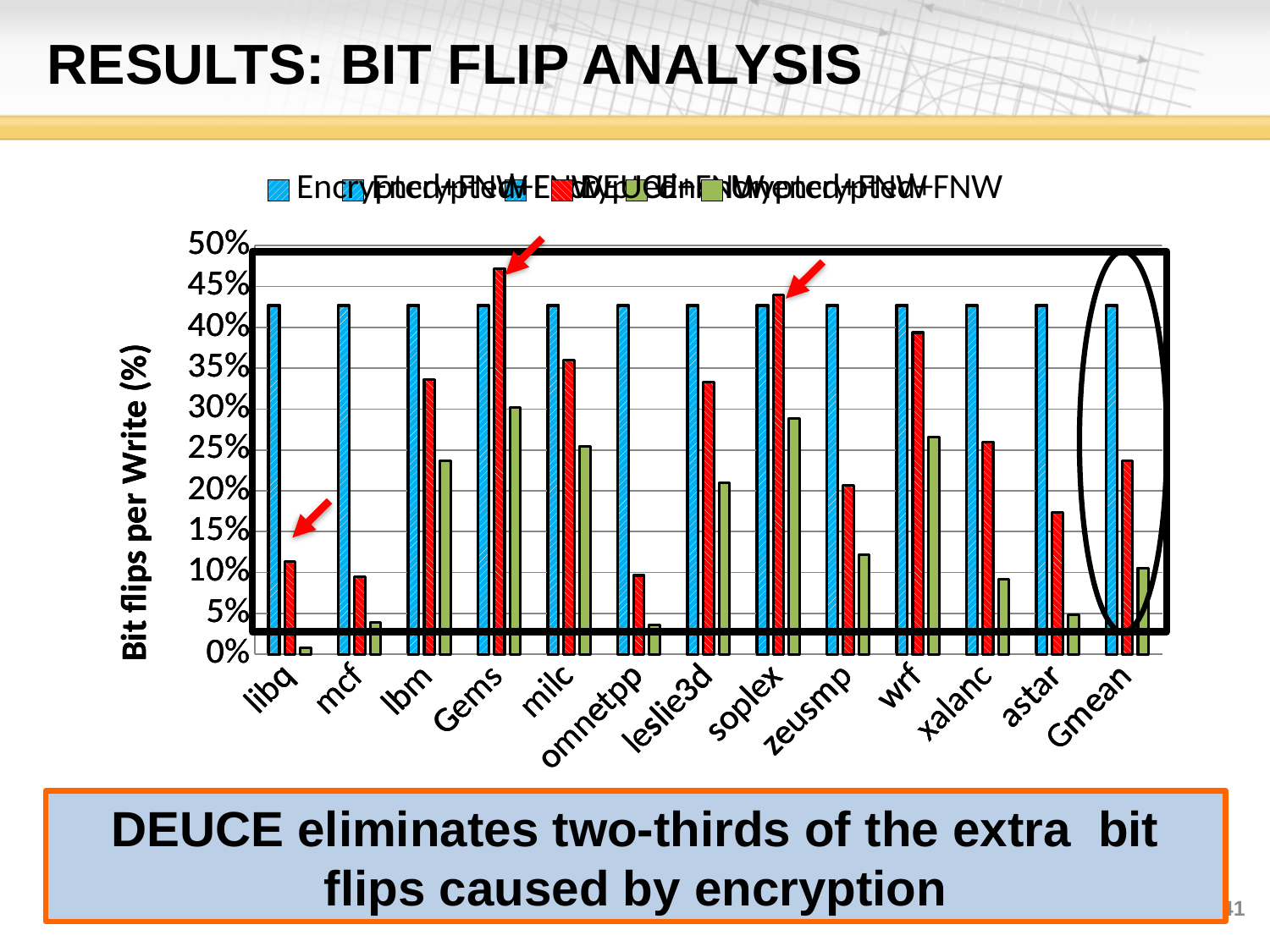
Which category has the tallest red bar? Gems What kind of chart is shown on the slide? bar chart Is the red bar for Gems greater or less than 45%? greater Which category on the x axis is circled on the chart? Gmean How many data series (bar colours) are plotted for each category? 3 Is the blue bar for libq greater or less than 40%? greater Which is larger, the red bar for wrf or the red bar for xalanc? wrf Is the red bar for Gmean greater or less than 25%? less How many categories are shown along the x axis of the chart? 13 What is the label of the y axis? Bit flips per Write (%) Which category has the shortest green bar? libq